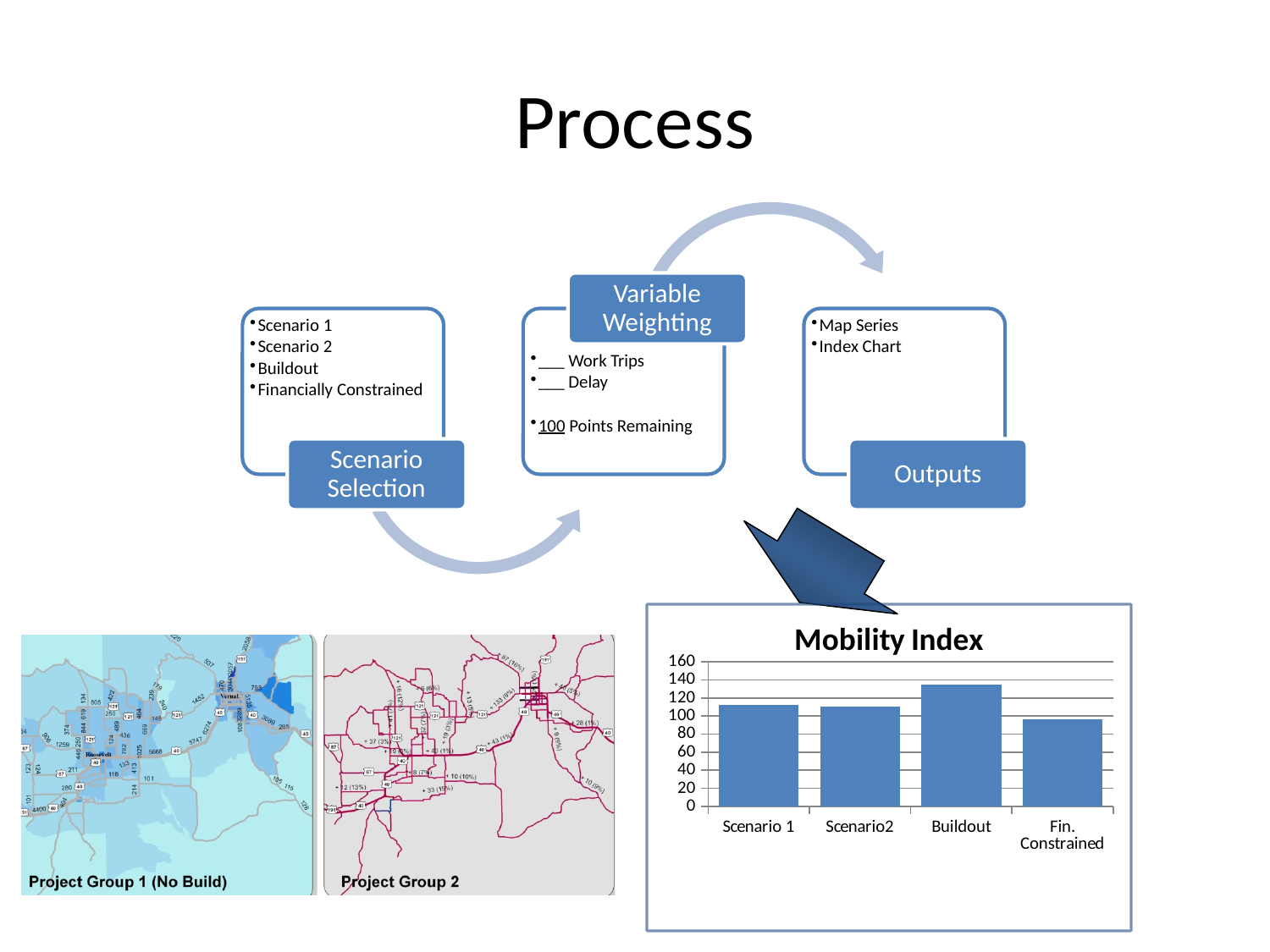
Is the Mobility Index for Fin. Constrained greater or less than 80? greater Which has a higher Mobility Index, Scenario 1 or Fin. Constrained? Scenario 1 Which category has the highest Mobility Index? Buildout How many categories are shown on the x axis of the Mobility Index chart? 4 Is the Mobility Index for Scenario2 greater or less than 120? less What is the title of the chart on the slide? Mobility Index Is the Mobility Index for Buildout greater or less than 140? less What kind of chart is the Mobility Index chart? bar chart Which has a higher Mobility Index, Buildout or Fin. Constrained? Buildout Which category has the lowest Mobility Index? Fin. Constrained